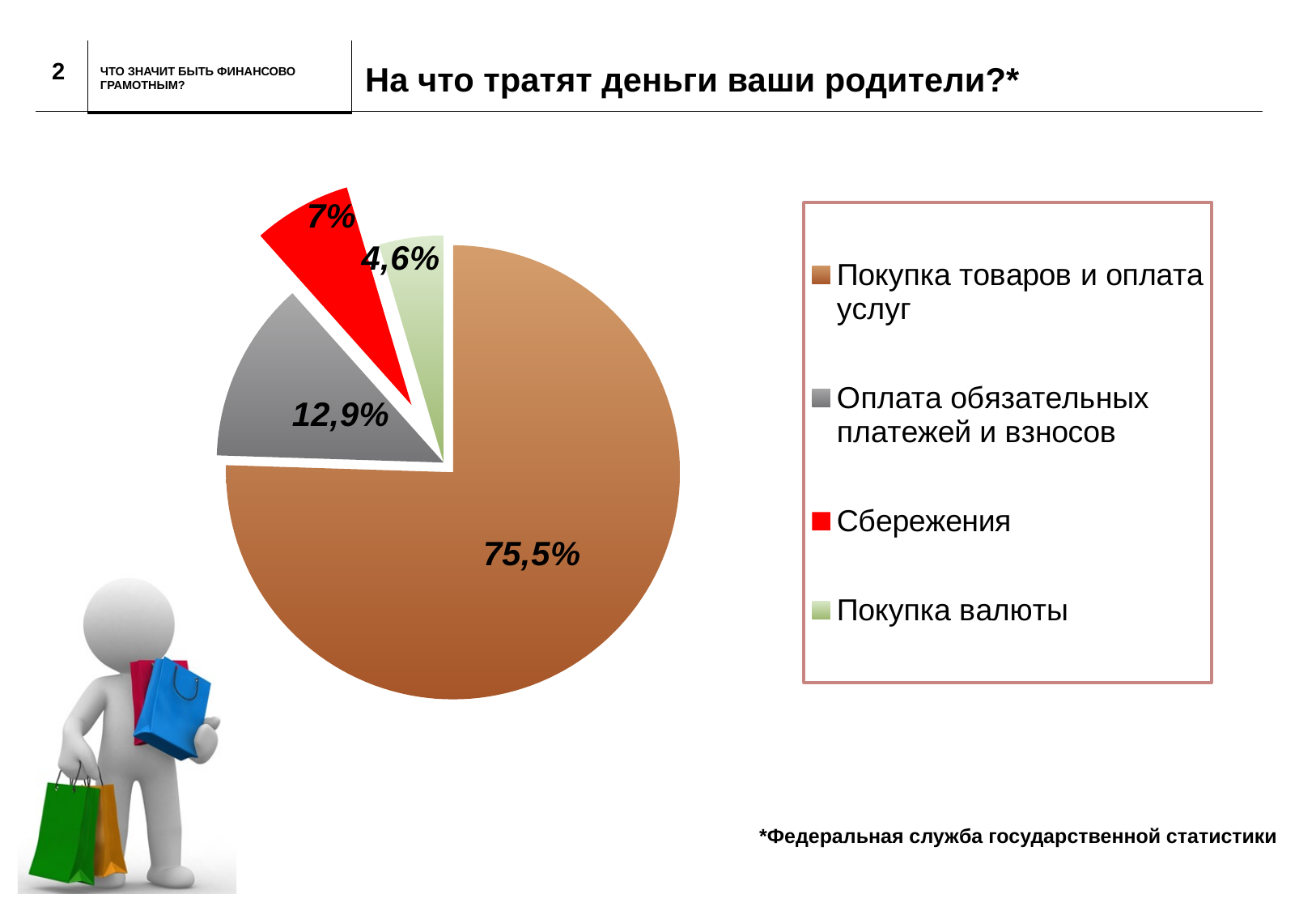
Which category has the smallest slice of the pie? Покупка валюты What kind of chart is shown on the slide? pie chart What is the title of the chart on the slide? На что тратят деньги ваши родители?* What share of the pie is labelled for Сбережения? 7% What share of the pie is labelled for Оплата обязательных платежей и взносов? 12,9% What share of the pie is labelled for Покупка валюты? 4,6% What is the difference between the shares for Оплата обязательных платежей и взносов and Сбережения? 5,9% Which is larger: the slice for Сбережения or the slice for Покупка валюты? Сбережения How many slices does the pie chart have? 4 What share of the pie is labelled for Покупка товаров и оплата услуг? 75,5% What colour is the slice for Сбережения? red Which category has the largest slice of the pie? Покупка товаров и оплата услуг